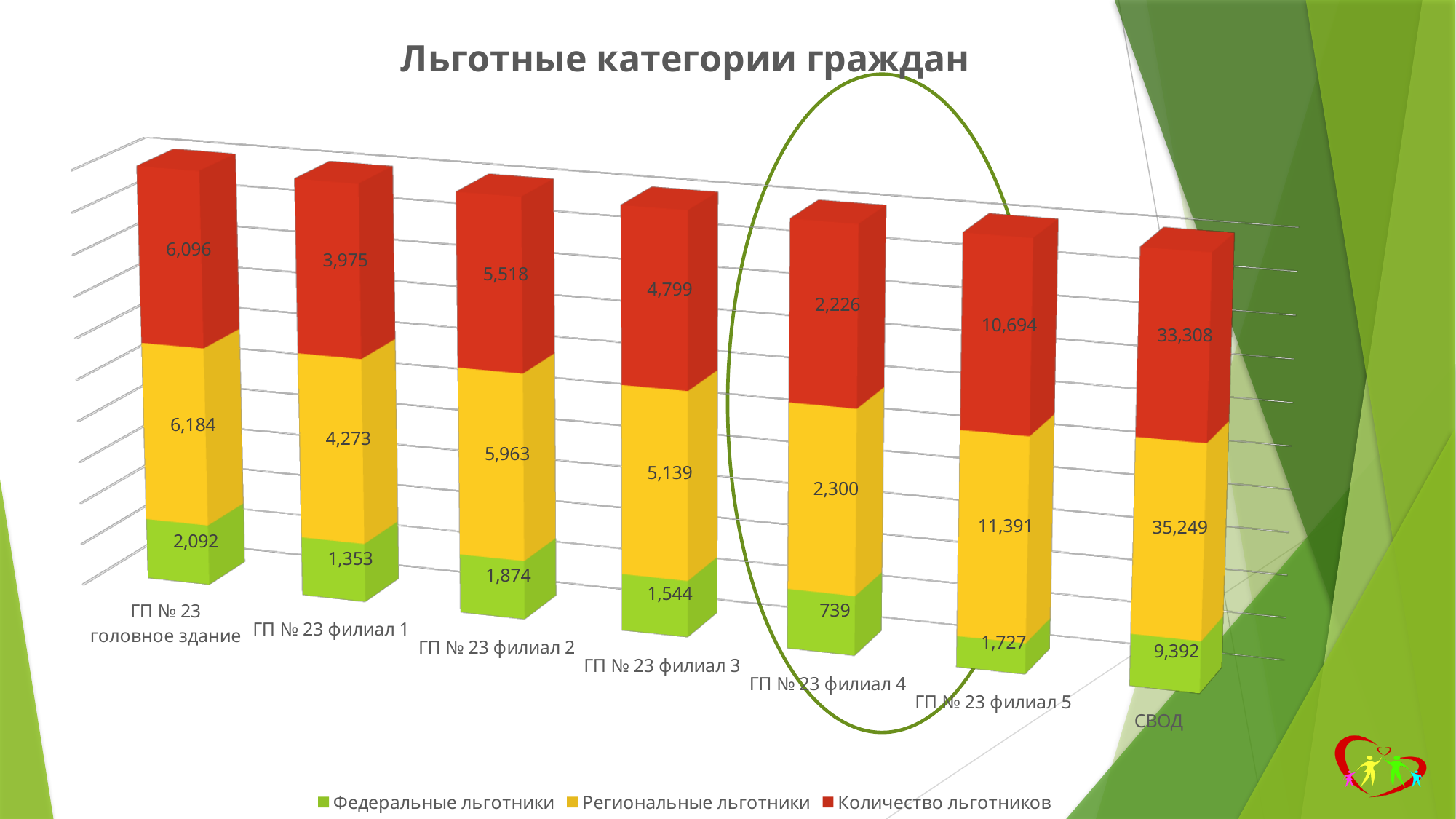
Which category has the lowest value for Федеральные льготники? ГП № 23 филиал 4 What is the value of Федеральные льготники for ГП № 23 филиал 4? 739 What is the value of Региональные льготники for ГП № 23 головное здание? 6,184 What is the title of the chart? Льготные категории граждан How many categories are shown on the x axis? 7 How many series does the legend list? 3 What is the difference between Федеральные льготники for ГП № 23 филиал 2 and ГП № 23 филиал 1? 521 What is the value of Количество льготников for СВОД? 33,308 What kind of chart is shown on the slide? Stacked bar chart Which is larger: Региональные льготники for ГП № 23 филиал 2 or for ГП № 23 филиал 3? ГП № 23 филиал 2 What is the value of Региональные льготники for ГП № 23 филиал 5? 11,391 Which category has the highest value for Количество льготников? СВОД